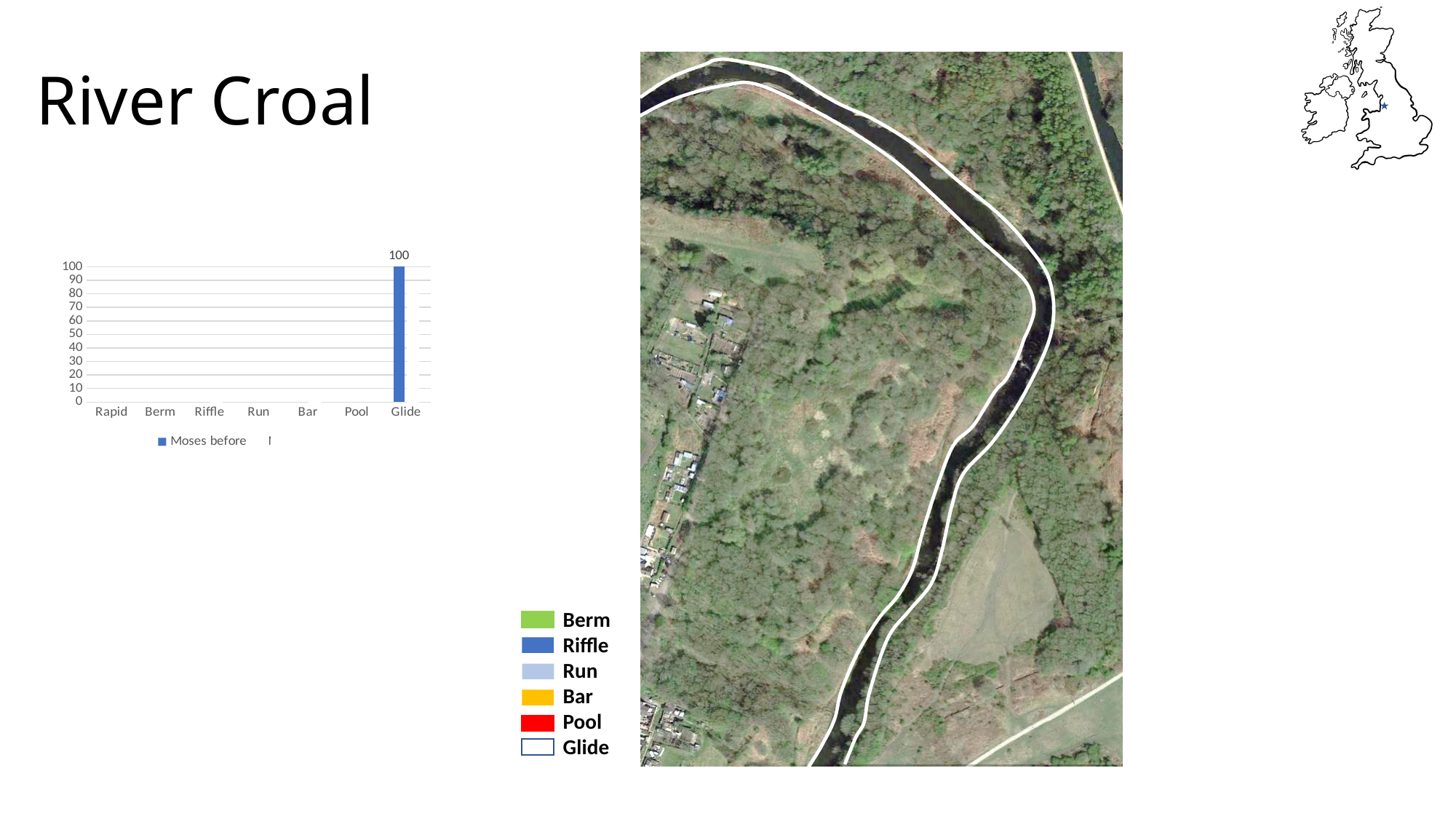
How many categories are shown on the x axis of the bar chart? 7 Which has the larger value in the bar chart, Run or Glide? Glide Is the value for Riffle greater or less than 10? less Is the value for Berm greater or less than 20? less Is the value for Rapid greater or less than 50? less What is the name of the series shown in blue in the bar chart legend? Moses before What is the value for Glide in the bar chart? 100 What colour is the bar for Glide in the bar chart? blue Which has the larger value in the bar chart, Glide or Pool? Glide What type of chart is shown on the slide? bar chart Which category has the highest value in the bar chart? Glide